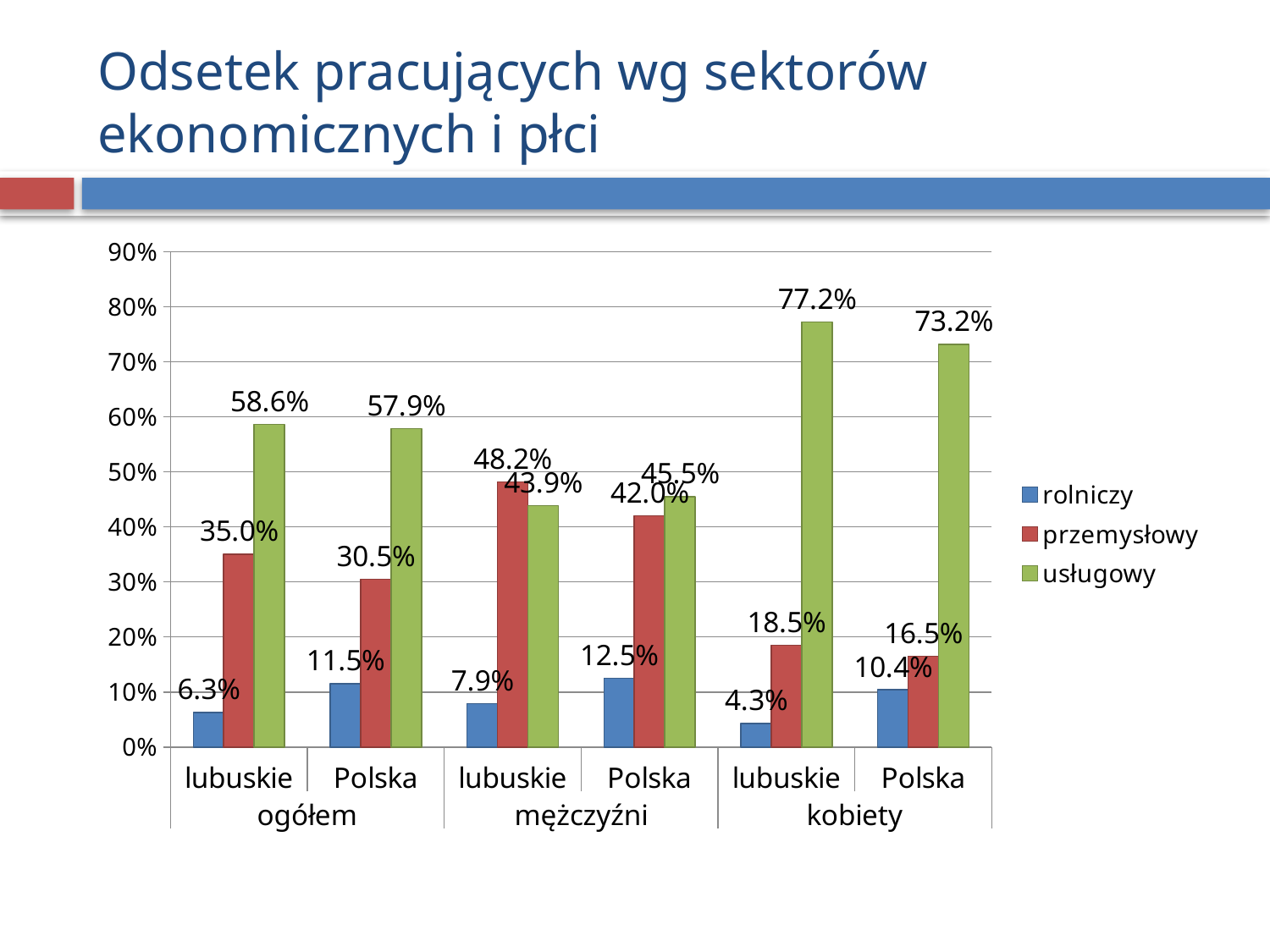
What is the value of usługowy for lubuskie in the kobiety group? 77.2% Which bar in the chart has the lowest value? rolniczy, lubuskie (kobiety) What kind of chart is shown on the slide? bar chart In the mężczyźni group for lubuskie, which is larger: przemysłowy or usługowy? przemysłowy What is the value of przemysłowy for lubuskie in the mężczyźni group? 48.2% How many series does the legend list? 3 Which bar in the chart has the highest value? usługowy, lubuskie (kobiety) Which colour represents the usługowy series? green Is the value of przemysłowy for Polska in the ogółem group greater or less than 40%? less What is the value of rolniczy for Polska in the ogółem group? 11.5% How many groups of bars are shown along the x axis? 6 What is the difference between the usługowy values for lubuskie and Polska in the kobiety group? 4.0%